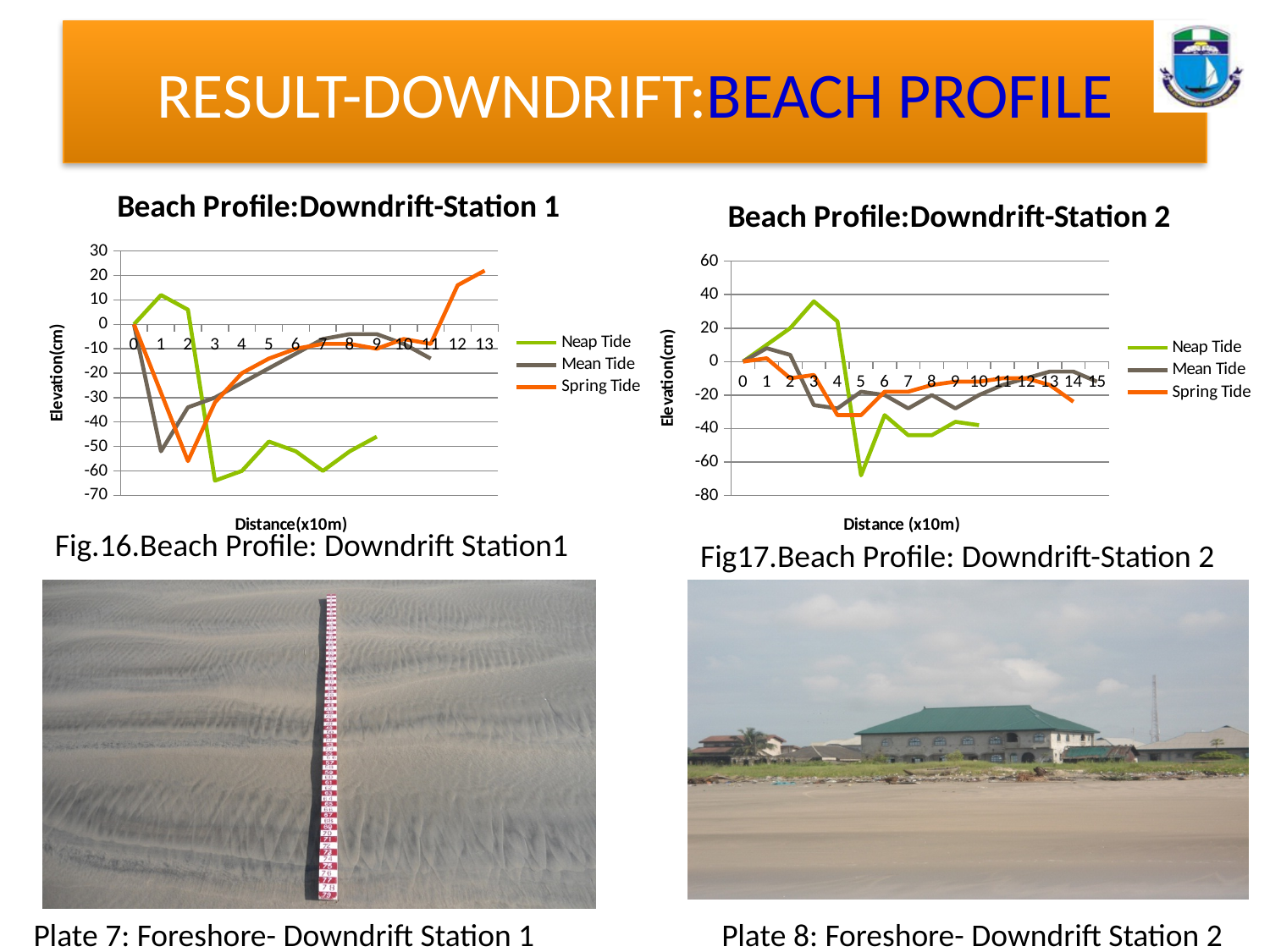
What is the y-axis title of the 'Beach Profile:Downdrift-Station 2' chart? Elevation(cm) In the 'Beach Profile:Downdrift-Station 2' chart, is the Neap Tide value at distance 5 greater or less than -40? less In the 'Beach Profile:Downdrift-Station 1' chart, is the Spring Tide value at distance 13 greater or less than 10? greater In the 'Beach Profile:Downdrift-Station 1' chart, is the Mean Tide value at distance 1 greater or less than -40? less What kind of chart is the 'Beach Profile:Downdrift-Station 1' chart? line chart In the 'Beach Profile:Downdrift-Station 1' chart, at distance 3, which is larger: the Neap Tide value or the Spring Tide value? Spring Tide In the 'Beach Profile:Downdrift-Station 1' chart, what are the three series named in the legend? Neap Tide, Mean Tide, Spring Tide How many series does the legend of the 'Beach Profile:Downdrift-Station 2' chart list? 3 In the 'Beach Profile:Downdrift-Station 2' chart, at distance 5, which is larger: the Neap Tide value or the Mean Tide value? Mean Tide